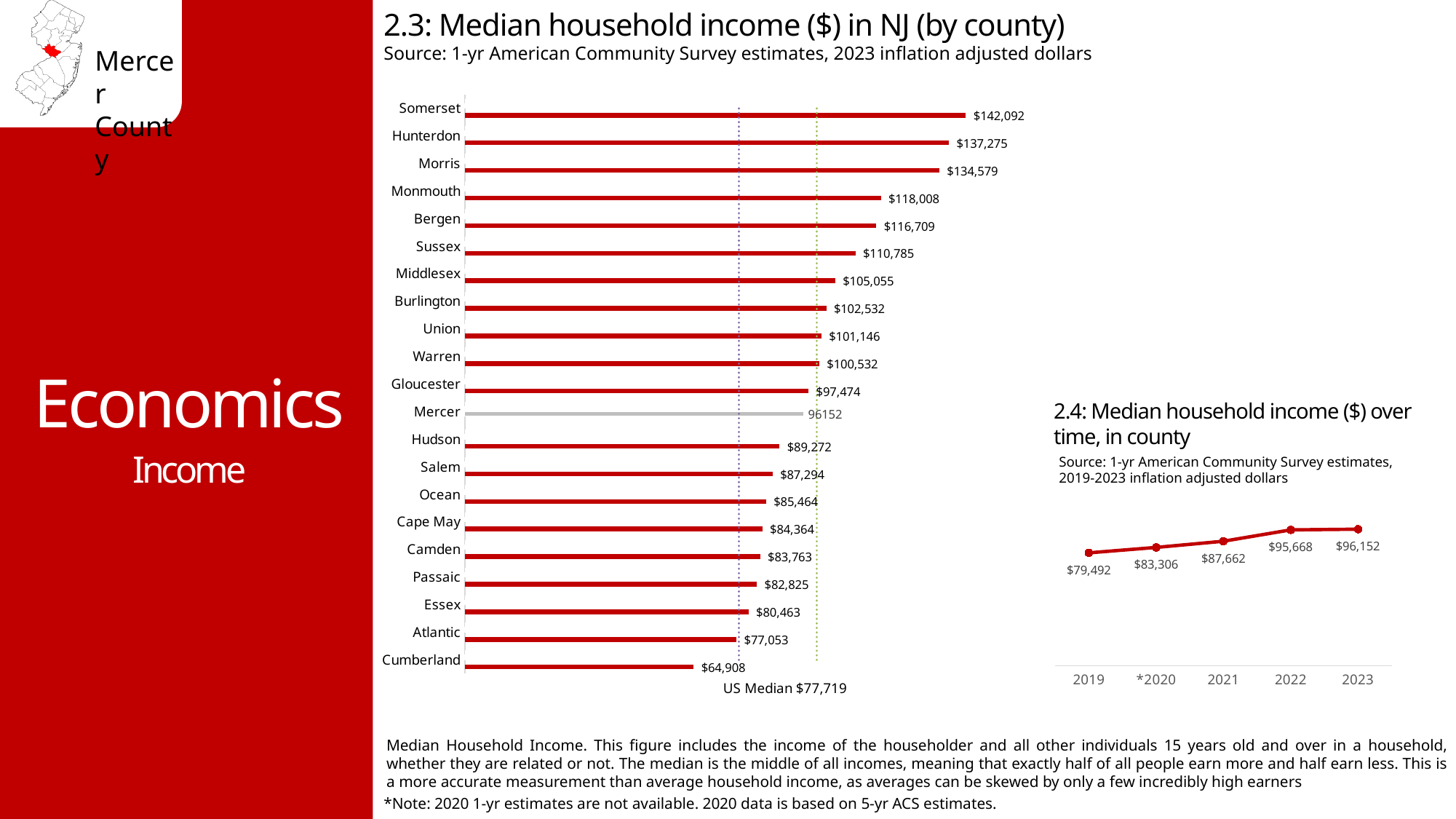
How many counties are shown in the chart '2.3: Median household income ($) in NJ (by county)'? 21 What US Median value is noted below the chart '2.3: Median household income ($) in NJ (by county)'? $77,719 In the chart '2.4: Median household income ($) over time, in county', what is the median household income for 2021? $87,662 In the chart '2.3: Median household income ($) in NJ (by county)', what is the median household income for Somerset? $142,092 In the chart '2.4: Median household income ($) over time, in county', what is the difference between the 2023 and 2019 values? $16,660 In the chart '2.3: Median household income ($) in NJ (by county)', which county has the lowest median household income? Cumberland In the chart '2.3: Median household income ($) in NJ (by county)', which county has the highest median household income? Somerset In the chart '2.4: Median household income ($) over time, in county', do the values rise or fall from 2019 to 2023? Rise What type of chart is '2.3: Median household income ($) in NJ (by county)'? Bar chart In the chart '2.3: Median household income ($) in NJ (by county)', what value is shown for Mercer? 96152 In the chart '2.3: Median household income ($) in NJ (by county)', what is the difference between Somerset's and Cumberland's median household income? $77,184 In the chart '2.3: Median household income ($) in NJ (by county)', which has a higher median household income, Hudson or Salem? Hudson